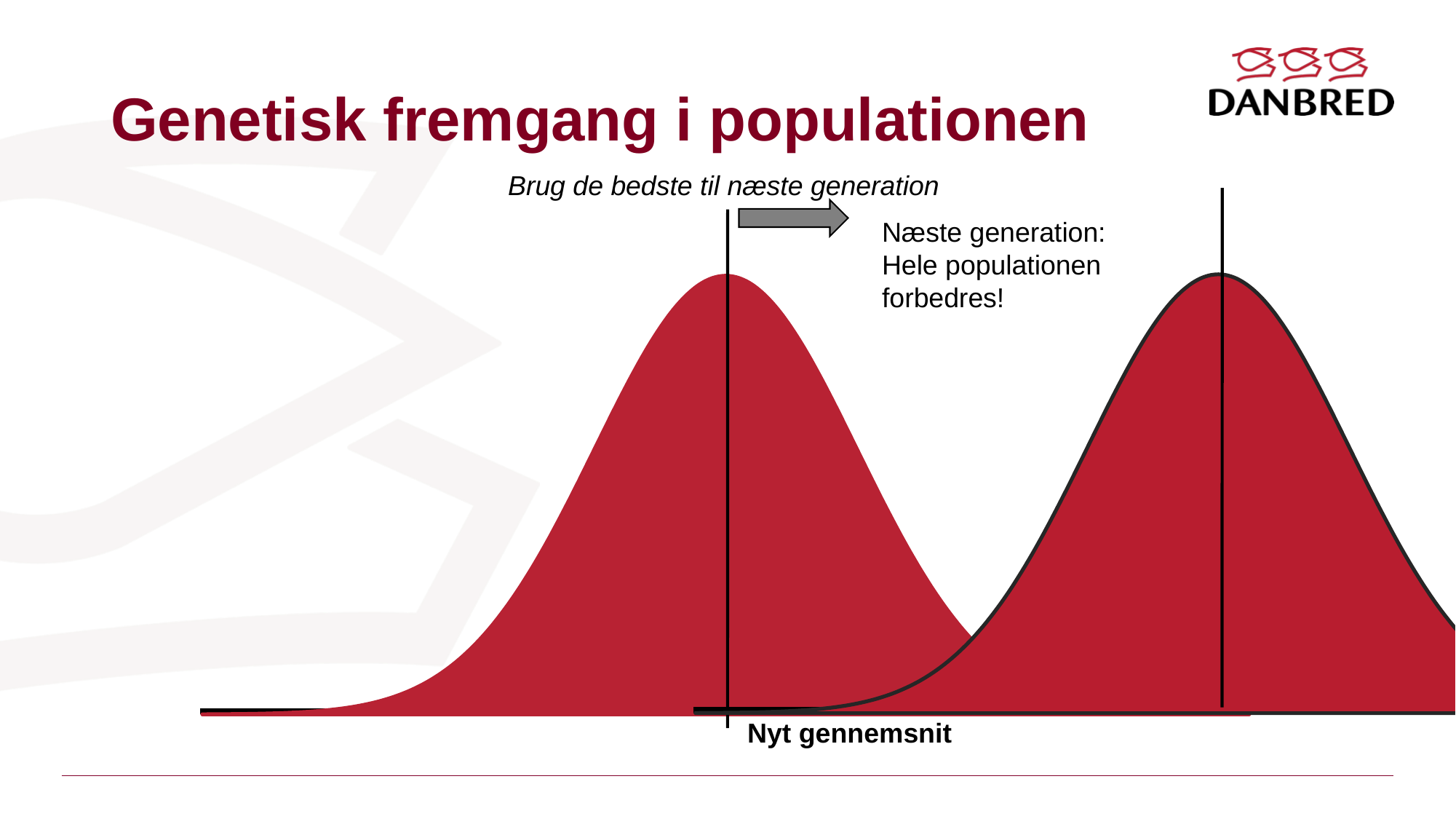
Is the peak of the right curve positioned to the left or to the right of the peak of the left curve? right What label is written below the vertical line through the peak of the left curve? Nyt gennemsnit How many bell-shaped distribution curves are drawn on the slide? 2 In which direction does the grey arrow above the curves point? right What colour are the two distribution curves filled with? red What is the title of the slide containing the distribution curves? Genetisk fremgang i populationen Does the second (next generation) distribution shift to higher or lower values along the x axis compared with the first? higher